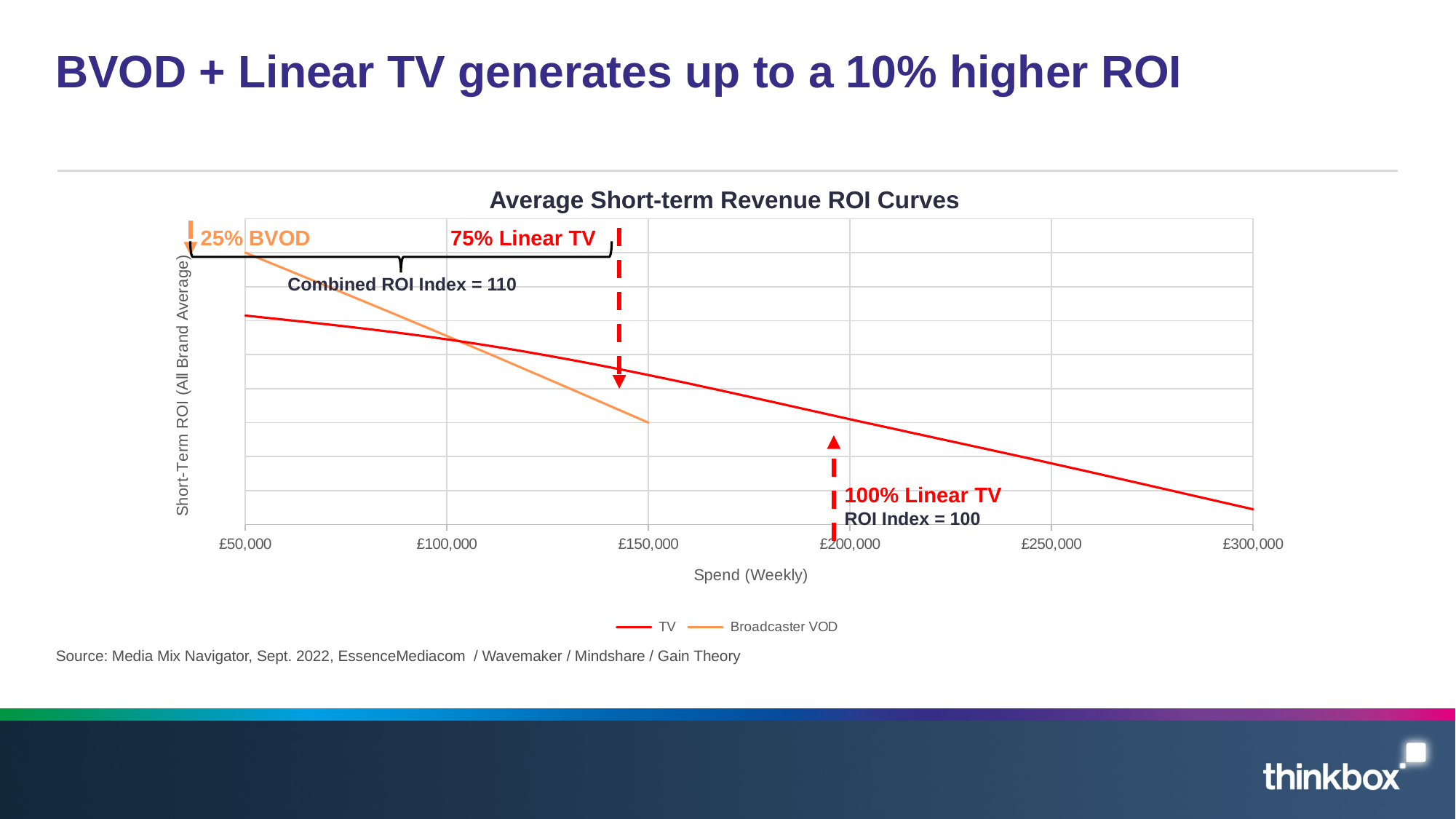
What is the Combined ROI Index shown for 25% BVOD plus 75% Linear TV? 110 At £50,000 weekly spend, which series has the higher short-term ROI, TV or Broadcaster VOD? Broadcaster VOD Which two series are listed in the chart legend? TV and Broadcaster VOD Does the TV line rise or fall as weekly spend increases along the x axis? Fall How many series does the legend list? 2 What ROI Index is shown for 100% Linear TV? 100 Which series extends all the way to £300,000 weekly spend? TV Does the Broadcaster VOD line rise or fall as weekly spend increases? Fall What is the title of the chart? Average Short-term Revenue ROI Curves What kind of chart is shown on the slide? Line chart How many spend values are labelled on the x axis? 6 At £150,000 weekly spend, which series has the higher short-term ROI, TV or Broadcaster VOD? TV